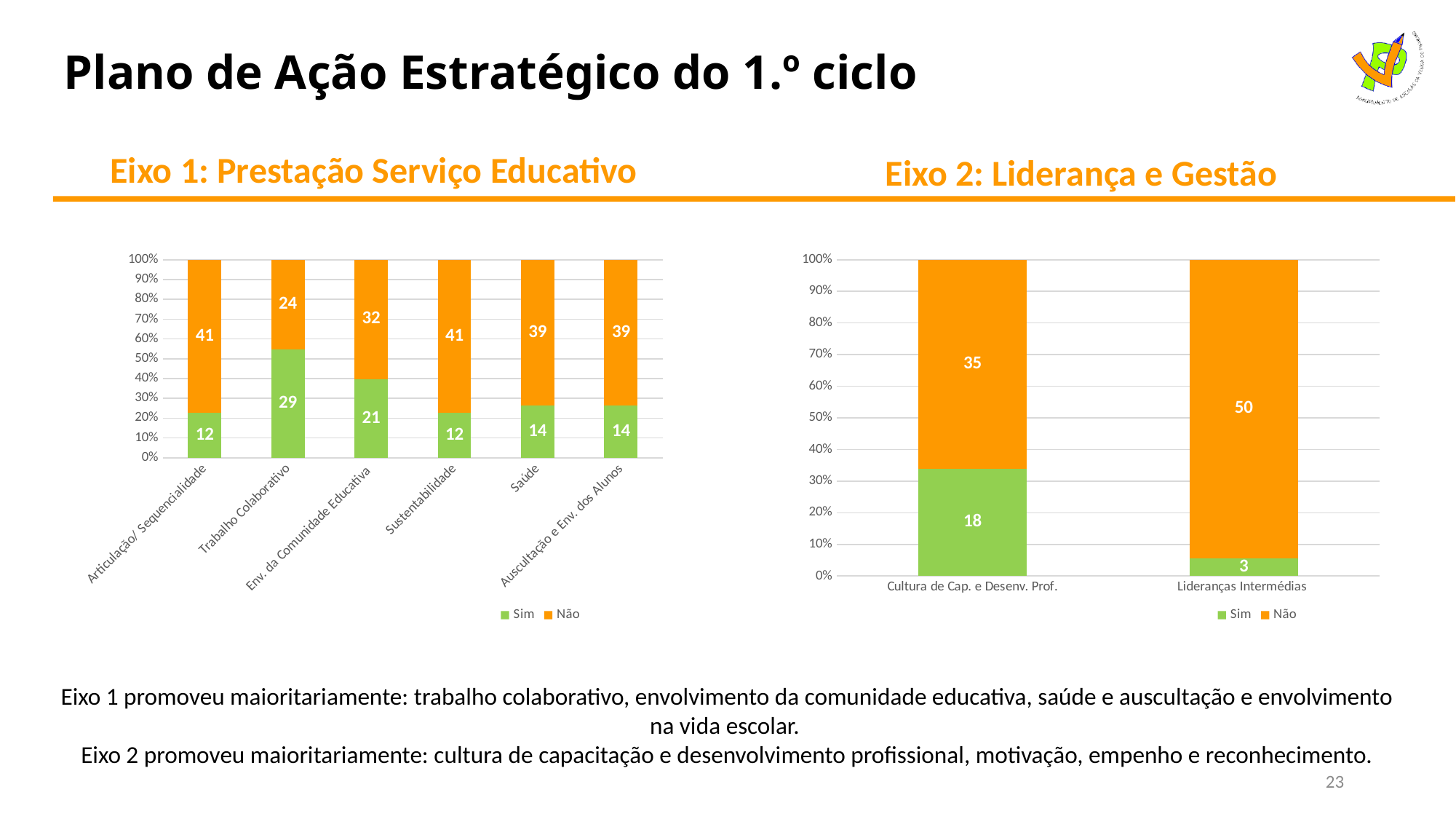
In the Eixo 1: Prestação Serviço Educativo chart, what is the difference between the Não and Sim values for Saúde? 25 In the Eixo 1: Prestação Serviço Educativo chart, is the Sim value for Sustentabilidade larger or smaller than the Sim value for Env. da Comunidade Educativa? smaller How many series does the legend of the Eixo 1: Prestação Serviço Educativo chart list? 2 What kind of chart is the Eixo 2: Liderança e Gestão chart? Stacked bar chart In the Eixo 1: Prestação Serviço Educativo chart, what is the Não value for Env. da Comunidade Educativa? 32 In the Eixo 2: Liderança e Gestão chart, what is the Não value for Lideranças Intermédias? 50 In the Eixo 1: Prestação Serviço Educativo chart, what is the Sim value for Trabalho Colaborativo? 29 In the Eixo 2: Liderança e Gestão chart, which category has the lowest Sim value? Lideranças Intermédias In the Eixo 2: Liderança e Gestão chart, what is the Sim value for Cultura de Cap. e Desenv. Prof.? 18 In the Eixo 1: Prestação Serviço Educativo chart, how many categories are shown on the x axis? 6 In the Eixo 1: Prestação Serviço Educativo chart, which category has the highest Sim value? Trabalho Colaborativo In the Eixo 2: Liderança e Gestão chart, what is the total of the Sim and Não values for Lideranças Intermédias? 53